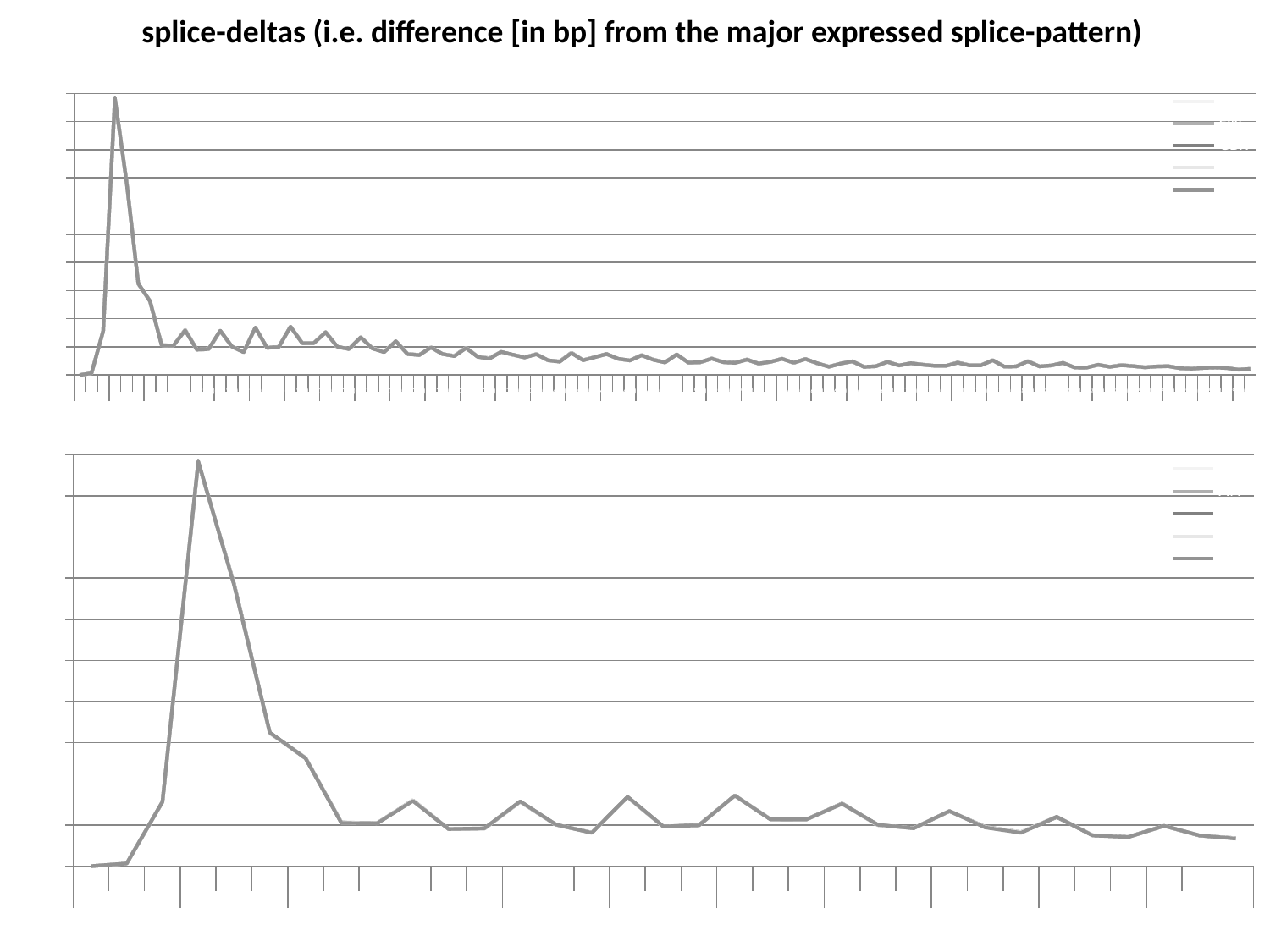
What kind of chart is the bottom chart on the slide? line chart What kind of chart is the top chart on the slide? line chart What is the title of the slide's charts? splice-deltas (i.e. difference [in bp] from the major expressed splice-pattern) How many charts are shown on the slide? 2 In the top chart, is the highest point of the line located near the left or near the right of the x axis? near the left In the top chart, after the sharp peak near the left, do the values generally rise or fall moving right along the x axis? fall In the bottom chart, is the highest point of the line located near the left or near the right of the x axis? near the left In the bottom chart, after the sharp peak near the left, do the values generally rise or fall moving right along the x axis? fall